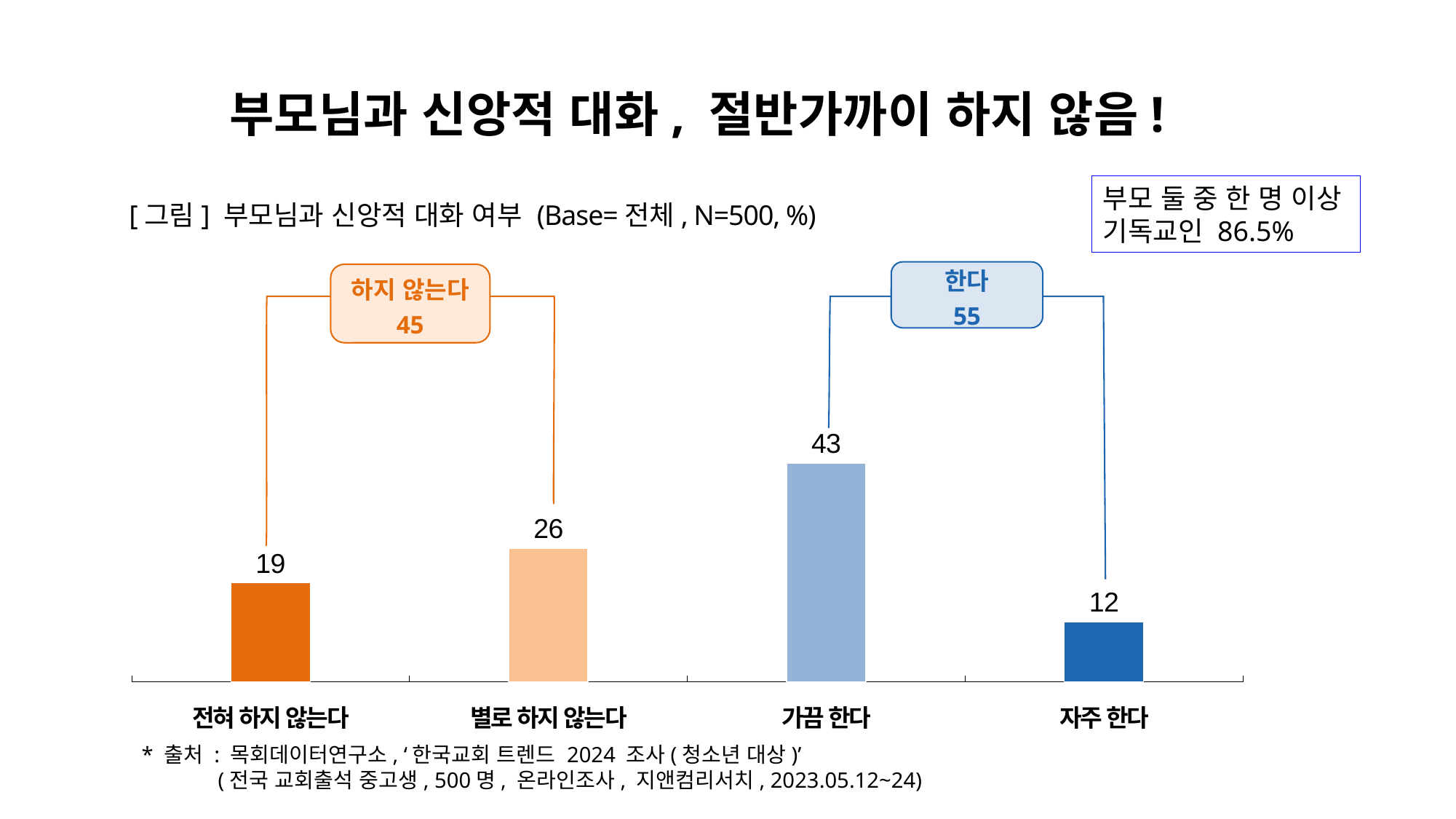
Which is larger, the value for 전혀 하지 않는다 or the value for 자주 한다? 전혀 하지 않는다 What is the difference between the values for 가끔 한다 and 별로 하지 않는다? 17 What combined value is shown in the 하지 않는다 bracket label? 45 What kind of chart is this? bar chart What is the value for 가끔 한다? 43 Which category has the lowest value? 자주 한다 What is the value for 전혀 하지 않는다? 19 What is the value for 별로 하지 않는다? 26 What is the value for 자주 한다? 12 Which category has the highest value? 가끔 한다 What combined value is shown in the 한다 bracket label? 55 How many categories are shown on the x axis? 4